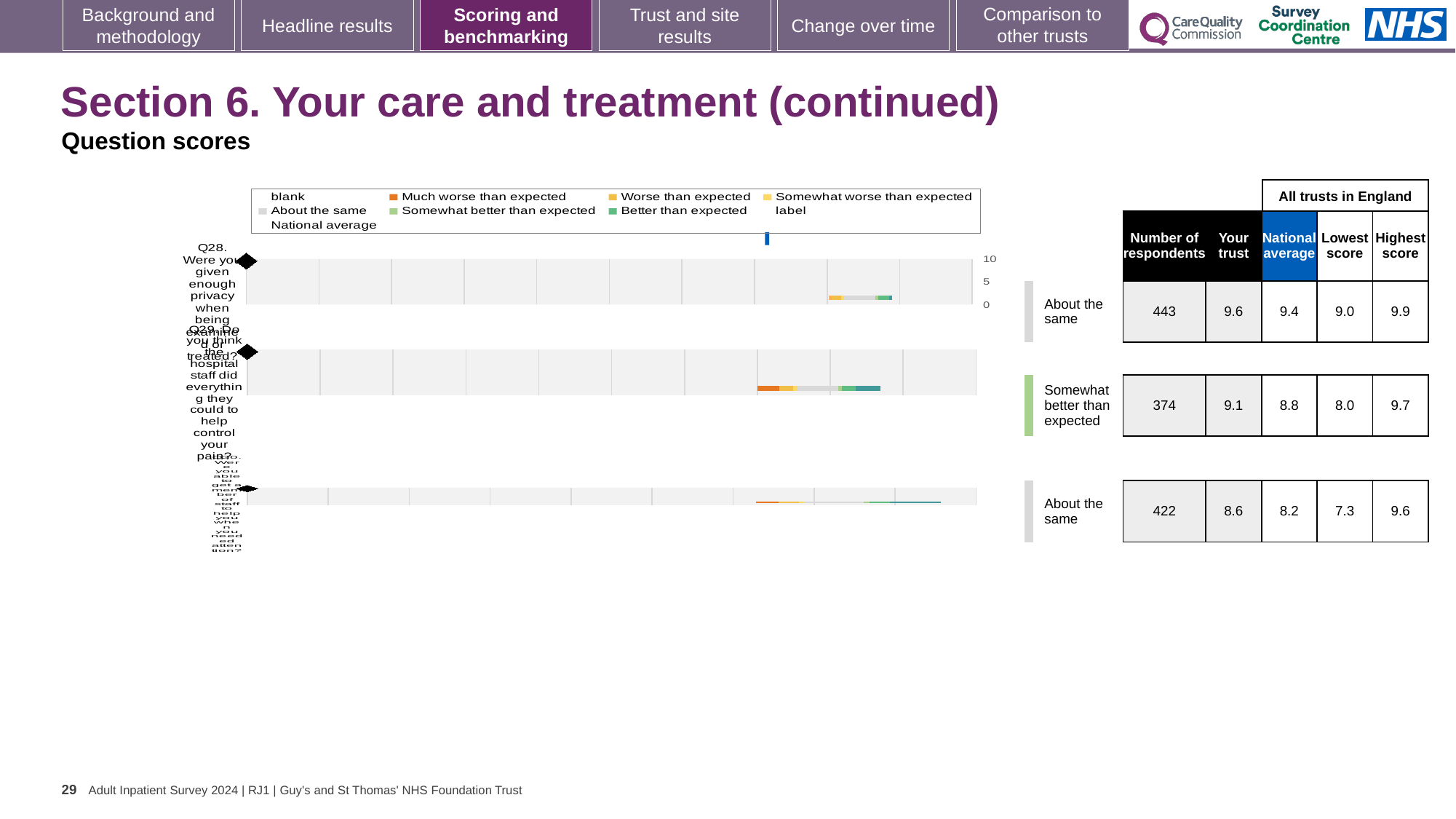
What is the 'Your trust' score for Q28 (privacy when being examined or treated)? 9.6 For Q29, how much higher is the 'Your trust' score than the national average? 0.3 Which question has the highest 'Your trust' score on this slide? Q28 What kind of chart is used to show the question scores on this slide? Bar chart How many questions are charted on this slide? 3 What is the highest score across all trusts in England for Q28? 9.9 What is the national average score for Q29 (hospital staff did everything to help control pain)? 8.8 Which has the larger 'Your trust' score, Q28 or Q30? Q28 Which question on this slide is rated 'Somewhat better than expected'? Q29 For Q30, what is the difference between the highest score and the lowest score across all trusts in England? 2.3 How many respondents answered Q30 (able to get a member of staff to help when needed)? 422 Which question has the lowest 'Lowest score' among all trusts in England? Q30